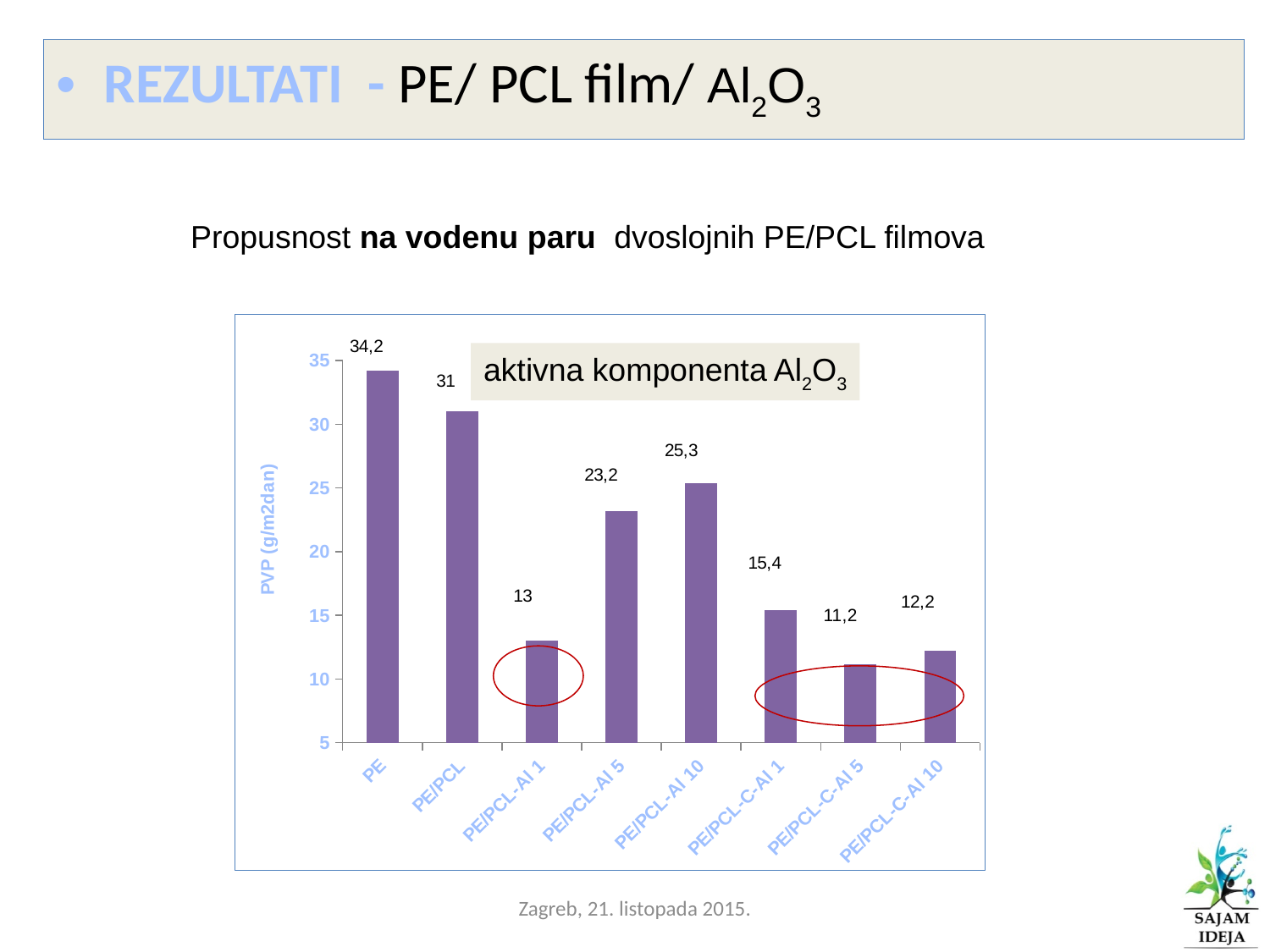
Which category has the lowest PVP value? PE/PCL-C-Al 5 What is the PVP value for PE? 34,2 What kind of chart is shown on the slide? bar chart What is the difference between the PVP values of PE and PE/PCL? 3,2 Is the PVP value for PE/PCL-Al 10 greater or less than 20? greater What is the PVP value for PE/PCL-Al 5? 23,2 Which has a larger PVP value, PE/PCL-Al 5 or PE/PCL-C-Al 10? PE/PCL-Al 5 Which category has the highest PVP value? PE What is the PVP value for PE/PCL-C-Al 1? 15,4 How many categories are shown on the x axis? 8 What is the label of the y axis? PVP (g/m2dan) What is the difference between the PVP values of PE/PCL-Al 10 and PE/PCL-Al 1? 12,3